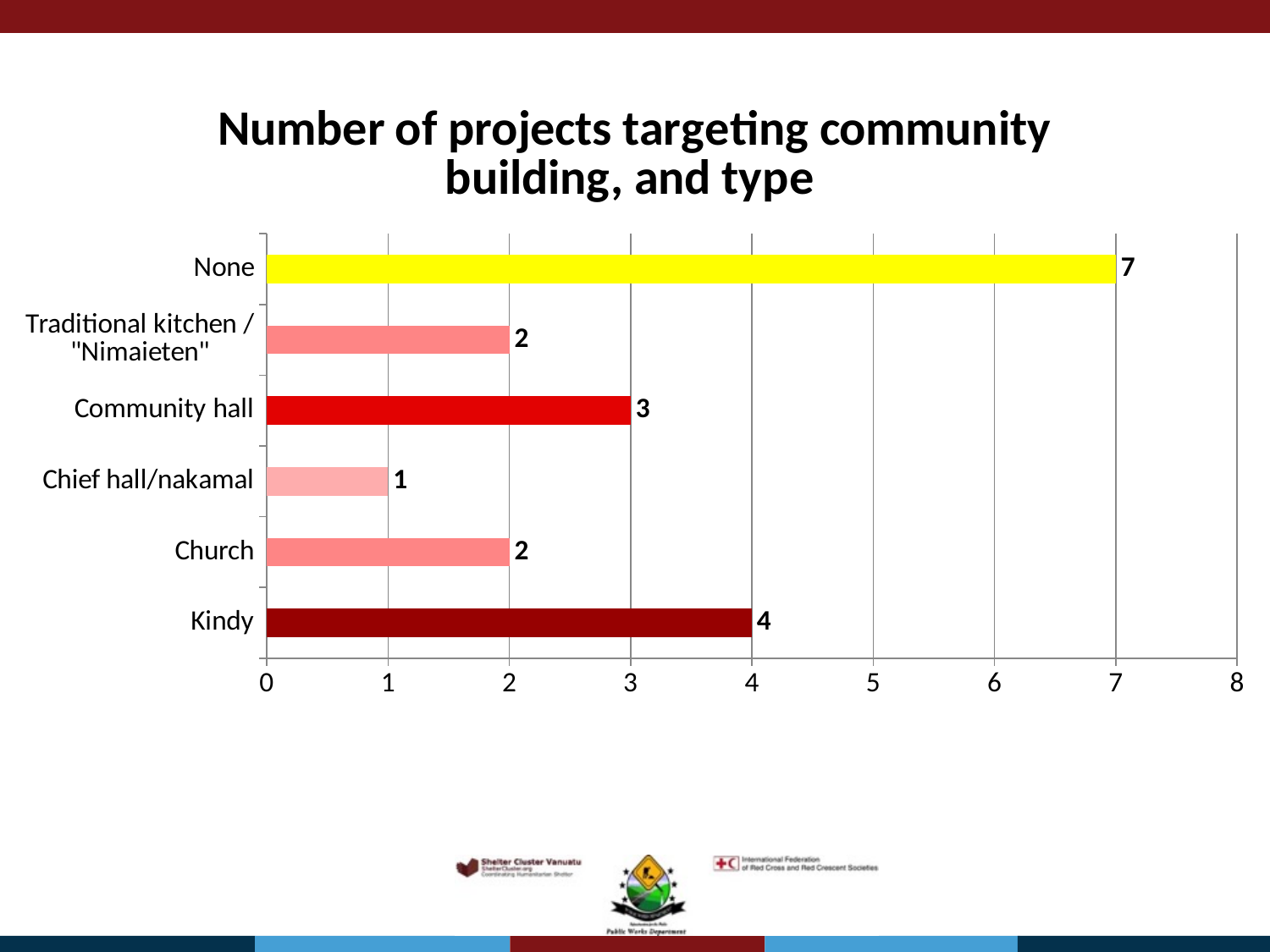
What is the title of the chart? Number of projects targeting community building, and type What is the number of projects for None? 7 What kind of chart is shown on the slide? Bar chart How many categories are shown in the chart? 6 Which has more projects, Community hall or Church? Community hall Which category has the highest number of projects? None What is the number of projects for Community hall? 3 What colour is the bar for None? Yellow What is the number of projects for Chief hall/nakamal? 1 What is the number of projects for Kindy? 4 Which category has the lowest number of projects? Chief hall/nakamal What is the difference between the number of projects for None and for Kindy? 3